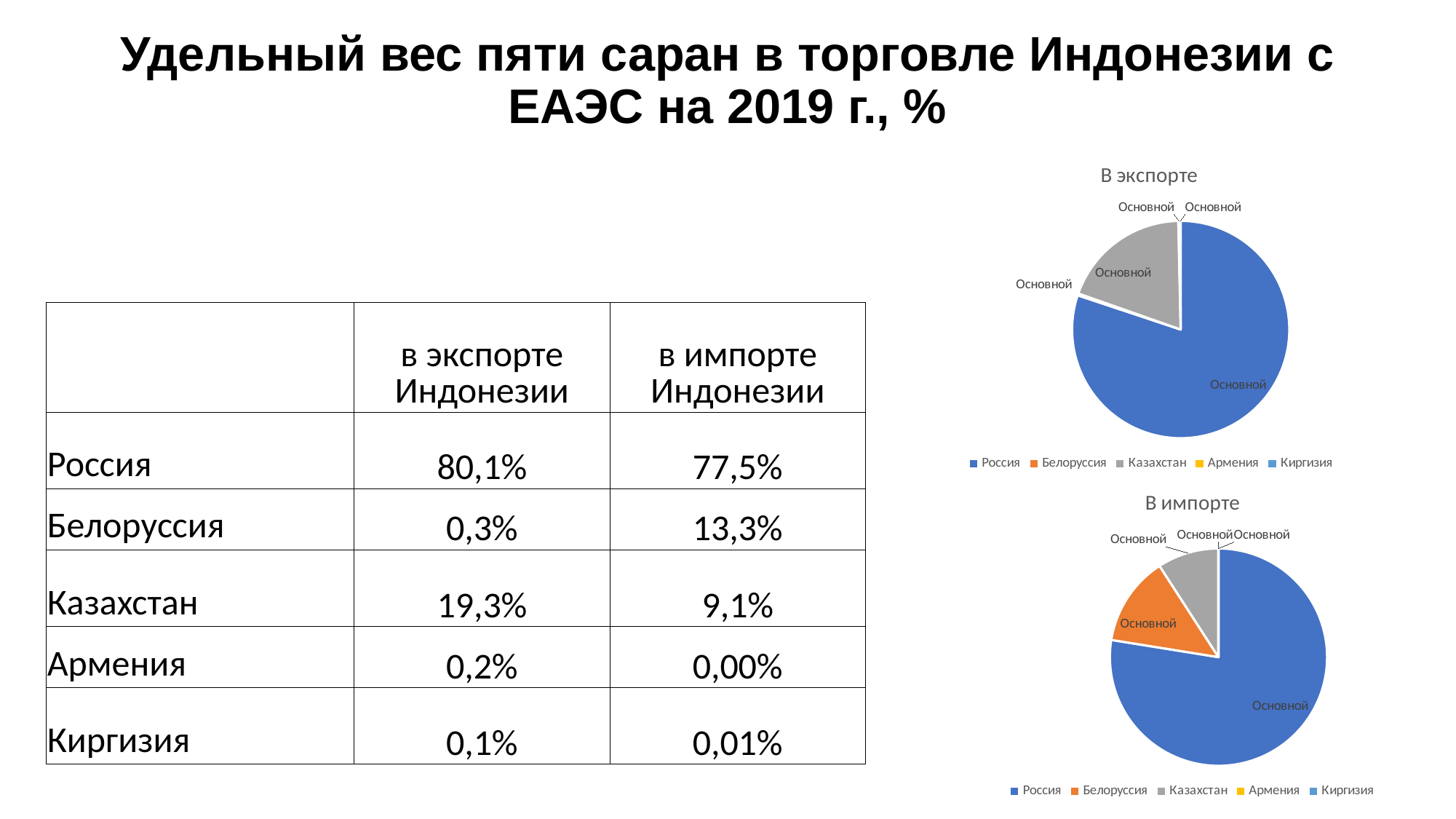
In the "В экспорте" pie chart, which country has the largest slice? Россия What kind of chart is the chart titled "В экспорте"? pie chart What kind of chart is the chart titled "В импорте"? pie chart How many pie charts are shown on the slide? 2 How many entries does the legend of the "В экспорте" chart list? 5 According to the slide, what is the share of Казахстан in the "В импорте" chart? 9,1% By how many percentage points does the share of Россия in the "В экспорте" chart exceed its share in the "В импорте" chart? 2,6 In the "В экспорте" pie chart, which slice is larger: Казахстан or Белоруссия? Казахстан According to the slide, what is the share of Россия in the "В экспорте" chart? 80,1% In the "В импорте" pie chart, which slice is larger: Белоруссия or Казахстан? Белоруссия What colour is the Россия slice in the "В импорте" pie chart? blue In the "В импорте" pie chart, which country has the largest slice? Россия